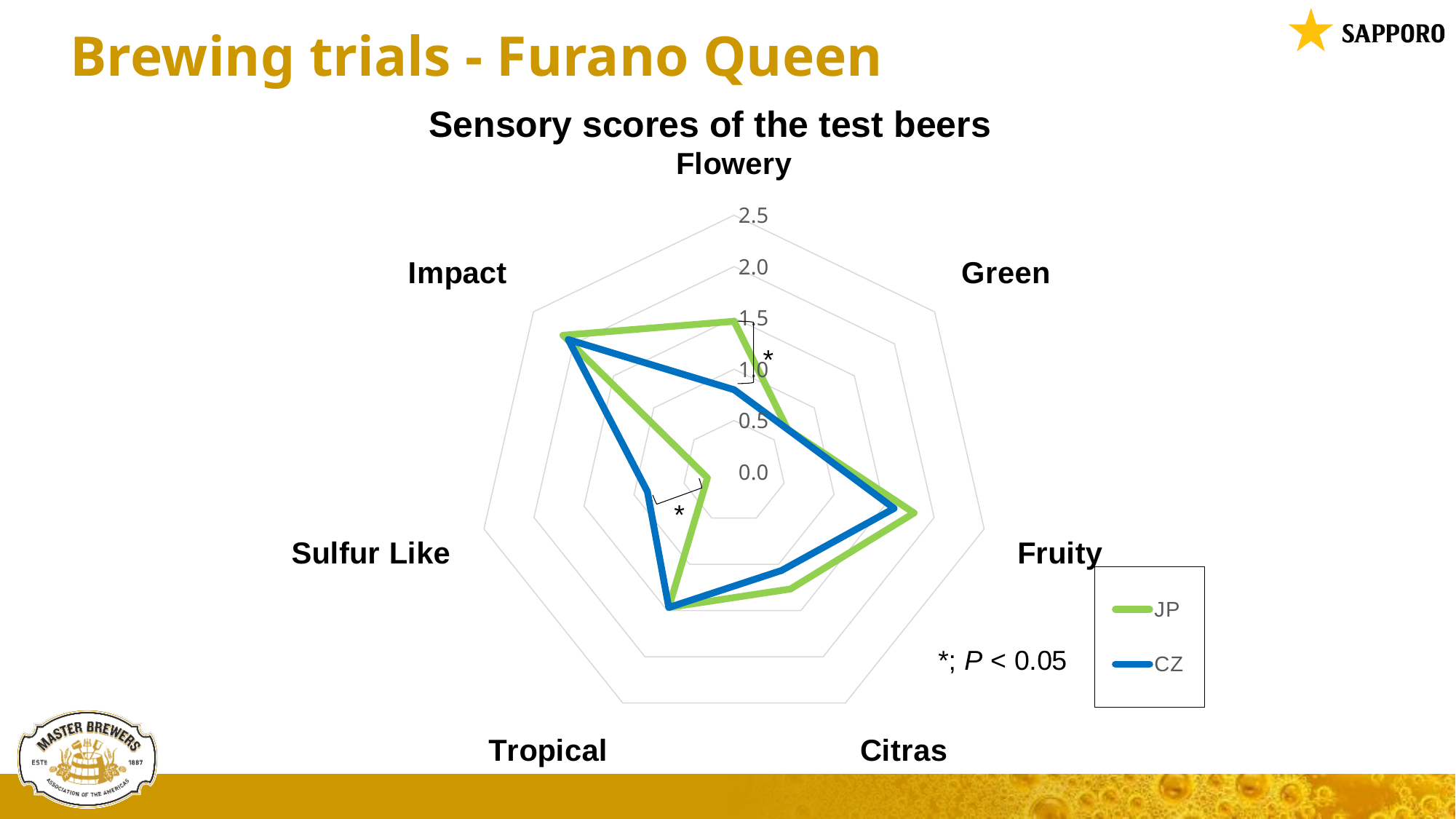
What kind of chart is shown on the slide? Radar chart How many series does the legend list? 2 How many sensory attributes (categories) are plotted on the radar chart? 7 For Sulfur Like, which series has the higher score, JP or CZ? CZ For Flowery, which series has the higher score, JP or CZ? JP Is the JP value for Green greater or less than 1.0? less Which series is drawn in blue? CZ Is the CZ value for Flowery greater or less than 1.5? less Is the JP value for Fruity greater or less than 1.5? greater What is the title of the chart? Sensory scores of the test beers